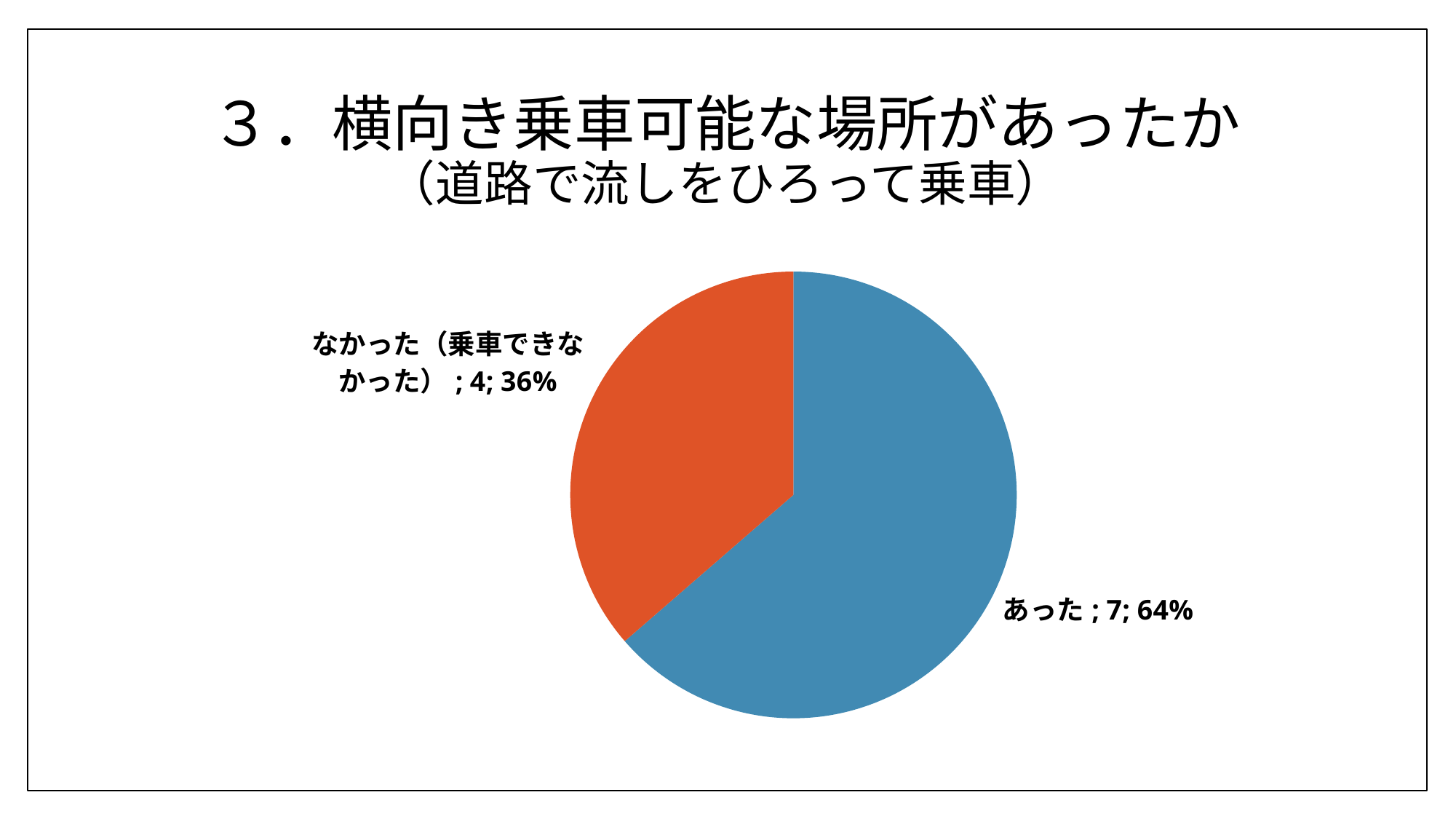
What is the total count across both slices? 11 What percentage share does the なかった（乗車できなかった） slice have? 36% Which slice is the smallest? なかった（乗車できなかった） Which is larger, the あった slice or the なかった（乗車できなかった） slice? あった What is the count for the なかった（乗車できなかった） slice? 4 What is the difference in count between the あった and なかった（乗車できなかった） slices? 3 Which slice is the largest? あった How many slices does the pie chart have? 2 What colour is the あった slice? blue What is the count for the あった slice? 7 What percentage share does the あった slice have? 64% What kind of chart is shown on the slide? pie chart